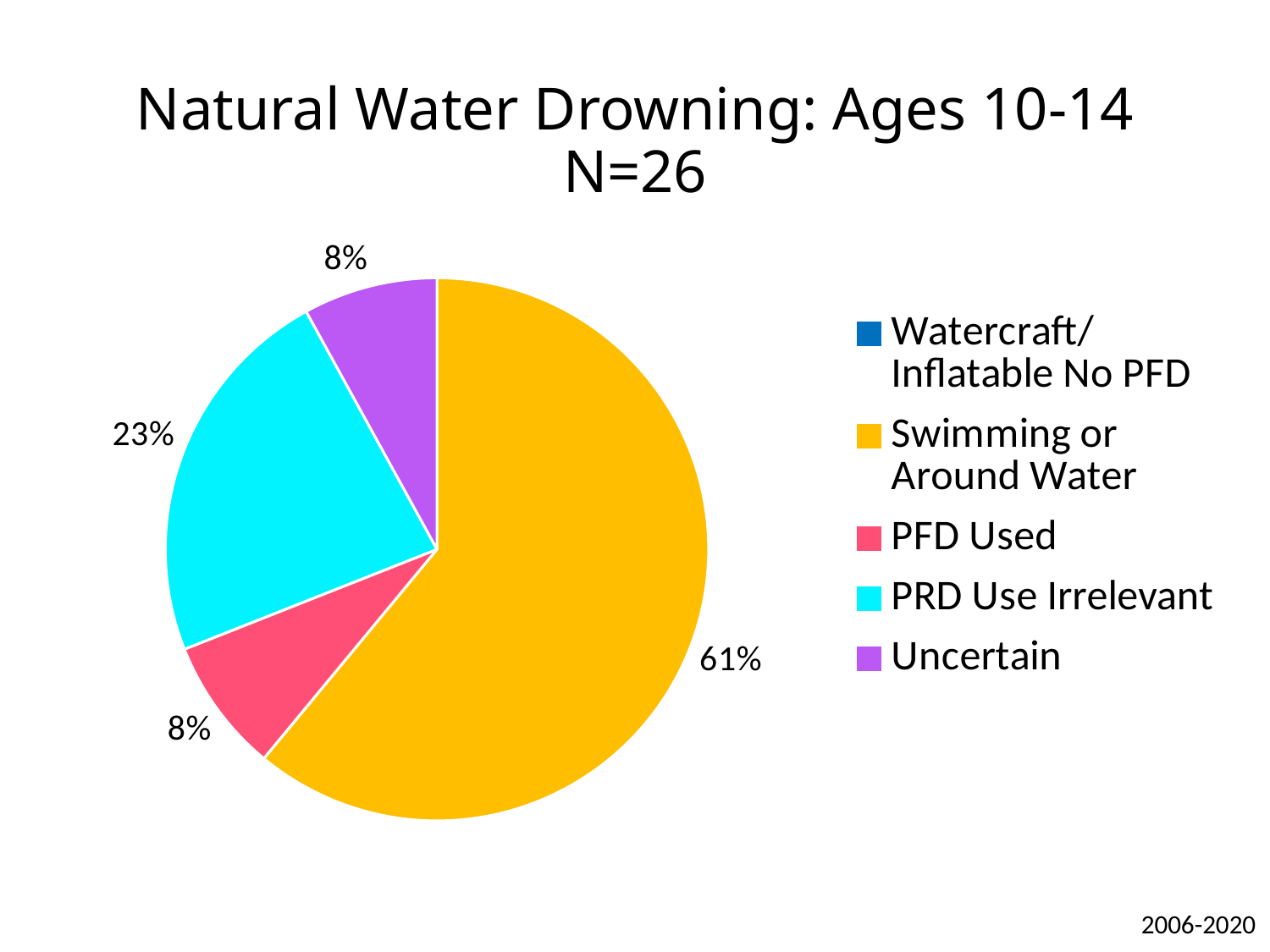
What type of chart is shown on the slide? pie chart What is the title of the chart? Natural Water Drowning: Ages 10-14 N=26 What percentage is shown for PRD Use Irrelevant? 23% What share of the pie is labelled for Swimming or Around Water? 61% What is the difference in percentage points between Swimming or Around Water and PRD Use Irrelevant? 38 What percentage is shown for PFD Used? 8% Which category has the largest slice of the pie? Swimming or Around Water What percentage is shown for Uncertain? 8% What colour is the slice for Uncertain? purple How many entries does the legend list? 5 Which is larger, the slice for PRD Use Irrelevant or the slice for PFD Used? PRD Use Irrelevant How many slices are visible in the pie? 4